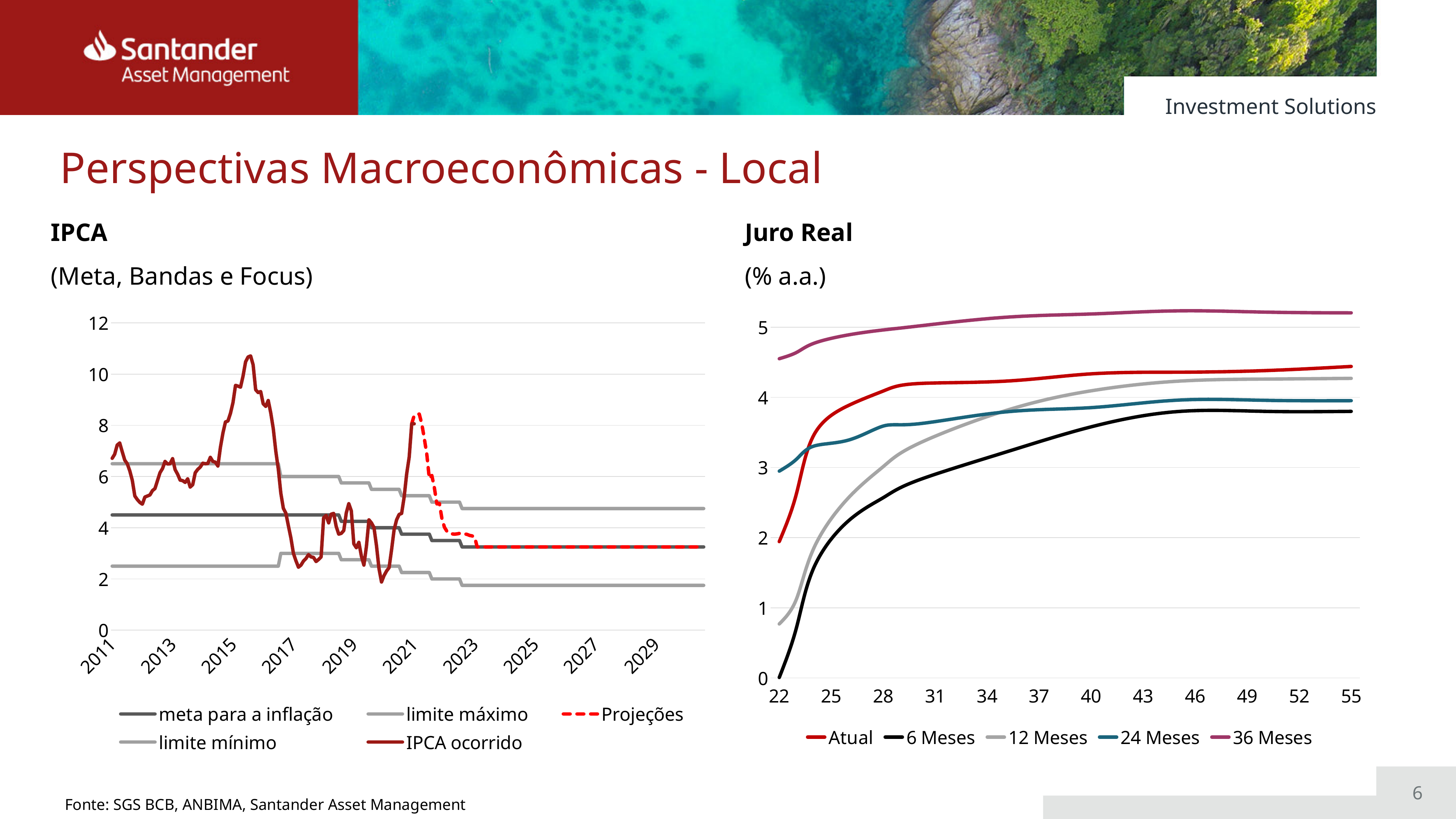
In the Juro Real chart, which series has the lowest value at 22? 6 Meses In the IPCA chart, is the value of limite máximo at 2029 greater or less than 6? less In the Juro Real chart, is the value of Atual at 22 greater or less than 3? less How many series does the legend of the Juro Real chart list? 5 In the Juro Real chart, does the 6 Meses series rise or fall along the x axis? rise In the IPCA chart, is the peak of IPCA ocorrido around 2016 greater or less than 10? greater In the Juro Real chart, which is larger at 55: 36 Meses or 6 Meses? 36 Meses In the IPCA chart, which series is drawn as a dashed red line? Projeções How many series does the legend of the IPCA chart list? 5 In the Juro Real chart, which series has the highest value at 55? 36 Meses What kind of chart is the IPCA chart on the left? line chart